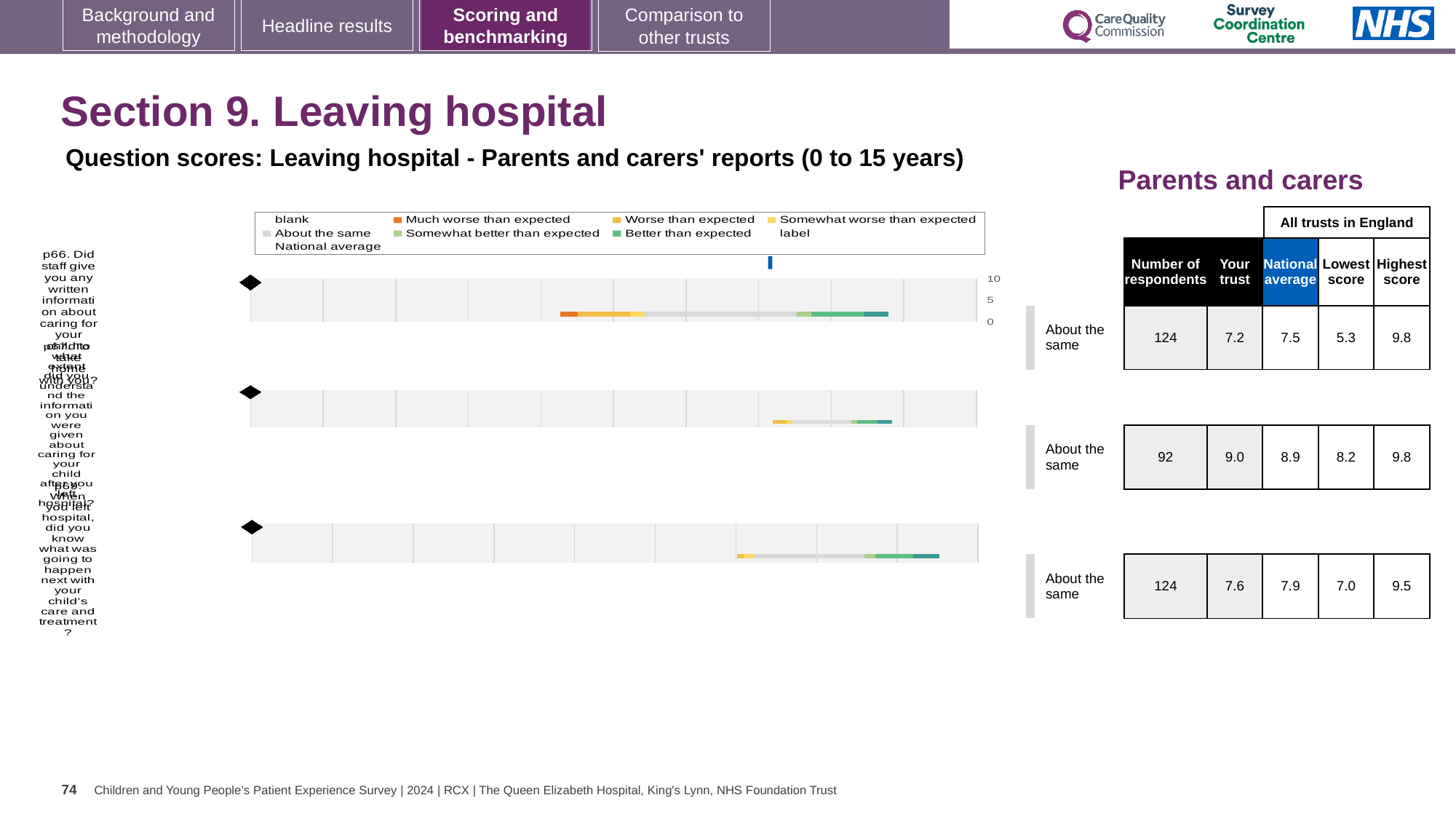
In the legend, which colour represents 'Much worse than expected'? orange How many entries does the legend above the charts list? 9 For the top chart (p66), what is the national average score shown in the table? 7.5 What is the highest tick value shown on the axis at the right of the top chart? 10 For the bottom chart, what is the highest score across all trusts in England? 9.5 How many separate question-score charts are shown on the slide? 3 For the middle chart, which is larger: the 'Your trust' score or the national average? Your trust For the top chart (p66), what is the difference between the national average and the 'Your trust' score? 0.3 For the top chart (p66), what is the 'Your trust' score shown in the table? 7.2 For the middle chart, how many respondents are shown in the table? 92 What benchmark category is shown next to each of the three charts? About the same What kind of chart is used to show the question scores on this slide? bar chart